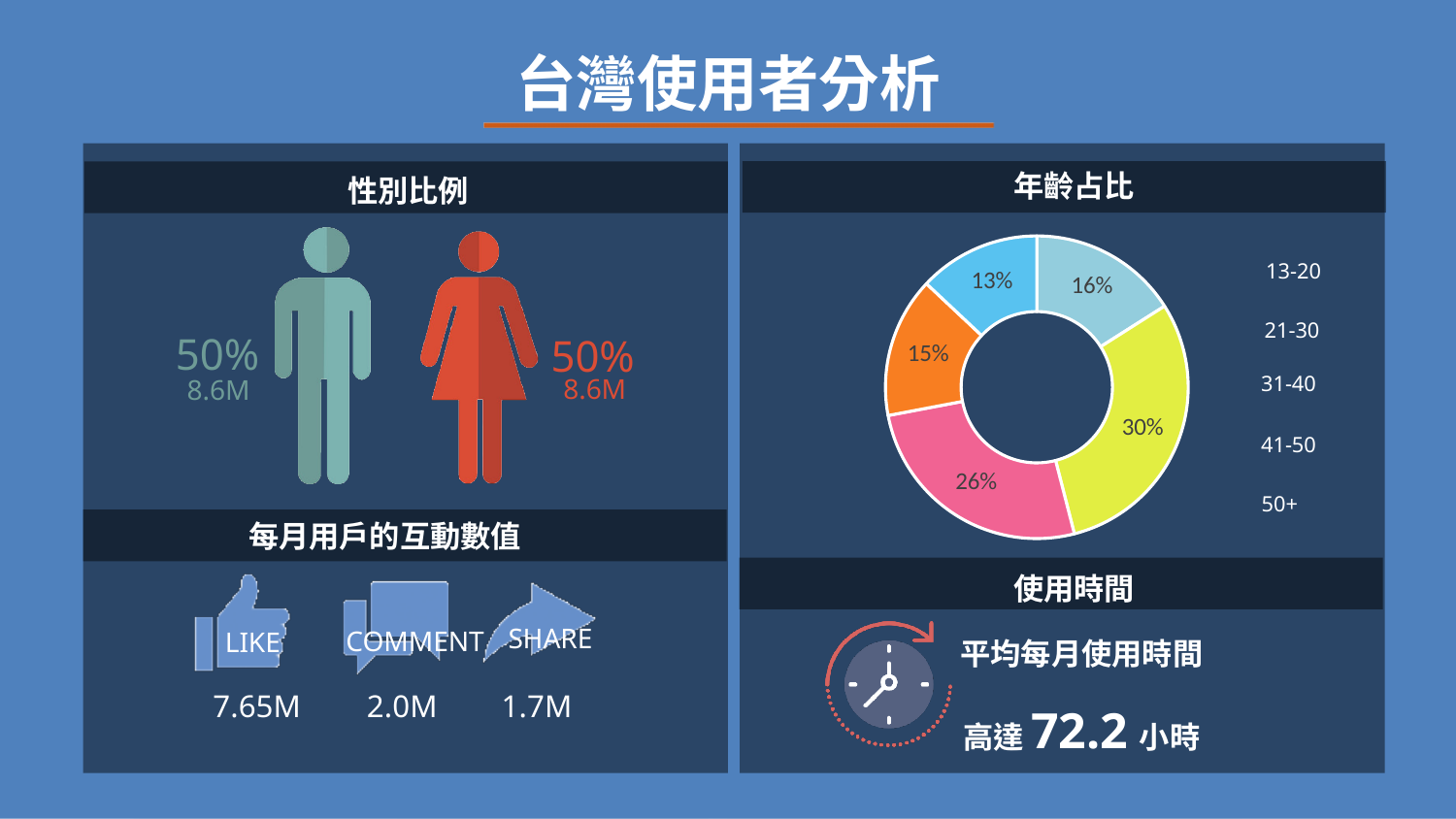
What is the smallest percentage shown on the 年齡占比 donut chart? 13% What kind of chart is used in the 年齡占比 panel? Donut chart How many age groups are listed beside the 年齡占比 donut chart? 5 What is the sum of the two smallest slices (15% and 13%) on the 年齡占比 donut chart? 28% What is the title of the donut chart on the right side of the slide? 年齡占比 On the 年齡占比 donut chart, what is the difference between the largest slice (30%) and the smallest slice (13%)? 17% What percentage is labelled on the orange slice of the 年齡占比 donut chart? 15% Which age group is listed last beside the 年齡占比 donut chart? 50+ What percentage is labelled on the light blue slice at the top of the 年齡占比 donut chart? 16% What is the largest percentage shown on the 年齡占比 donut chart? 30% How many slices does the 年齡占比 donut chart have? 5 On the 年齡占比 donut chart, which is larger: the yellow slice or the pink slice? The yellow slice (30%)